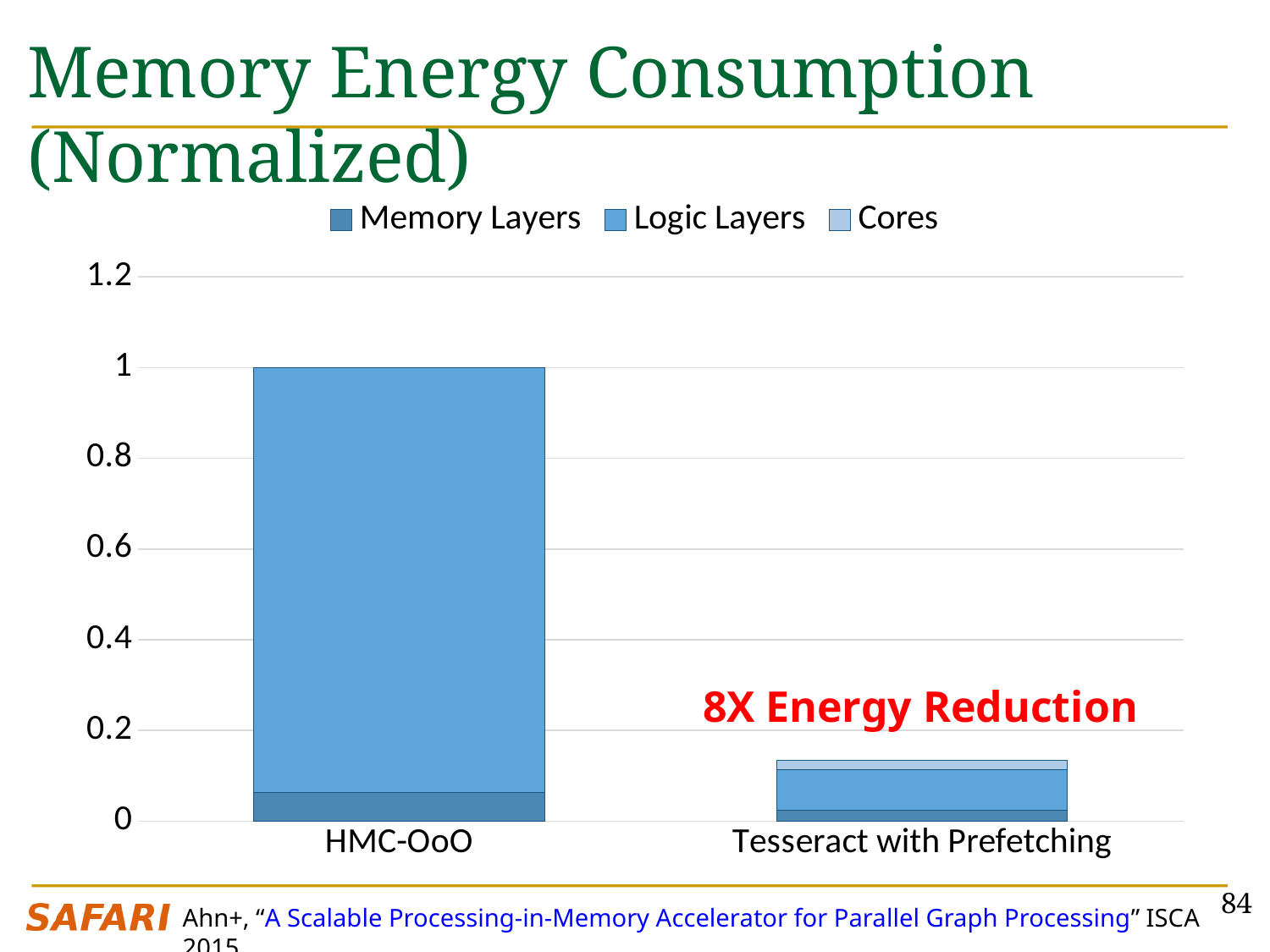
How many categories are shown on the x axis of the chart? 2 What kind of chart is shown on the slide? Stacked bar chart What is the total height of the stacked bar for HMC-OoO? 1 Which category has the lowest total normalized memory energy consumption? Tesseract with Prefetching What are the three series listed in the chart legend? Memory Layers, Logic Layers, Cores How many series does the chart legend list? 3 Which has a larger total bar, HMC-OoO or Tesseract with Prefetching? HMC-OoO What energy reduction does the red annotation on the chart state? 8X Energy Reduction Is the Memory Layers value for HMC-OoO greater or less than 0.2? less Is the total value for Tesseract with Prefetching greater or less than 0.2? less Is the total value for HMC-OoO greater or less than 0.8? greater Which category has the highest total normalized memory energy consumption? HMC-OoO